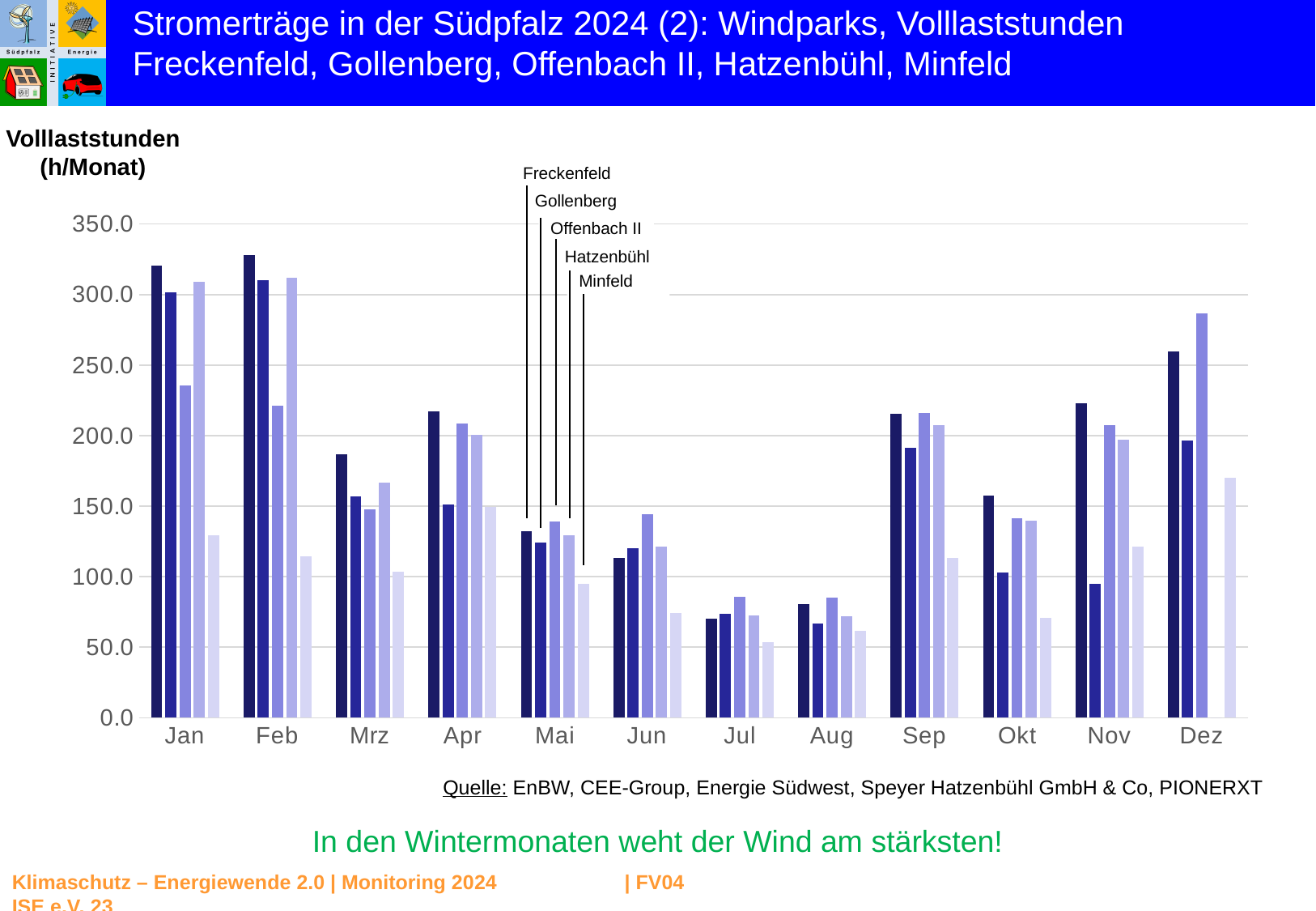
Is the value for Freckenfeld in Jan greater or less than 300? greater How many months are shown on the x axis of the chart? 12 Is the value for Minfeld in Jan greater or less than 150? less Is the value for Hatzenbühl in Dez greater or less than 250? less In which month is the Freckenfeld value lowest? Jul How many wind parks (series) does the chart legend list? 5 In Dez, which is larger: Hatzenbühl or Gollenberg? Gollenberg In Mai, which is larger: Offenbach II or Minfeld? Offenbach II What is the label of the y axis of the chart? Volllaststunden (h/Monat) What kind of chart is shown on the slide? bar chart Which wind park has the lowest value in Nov? Gollenberg